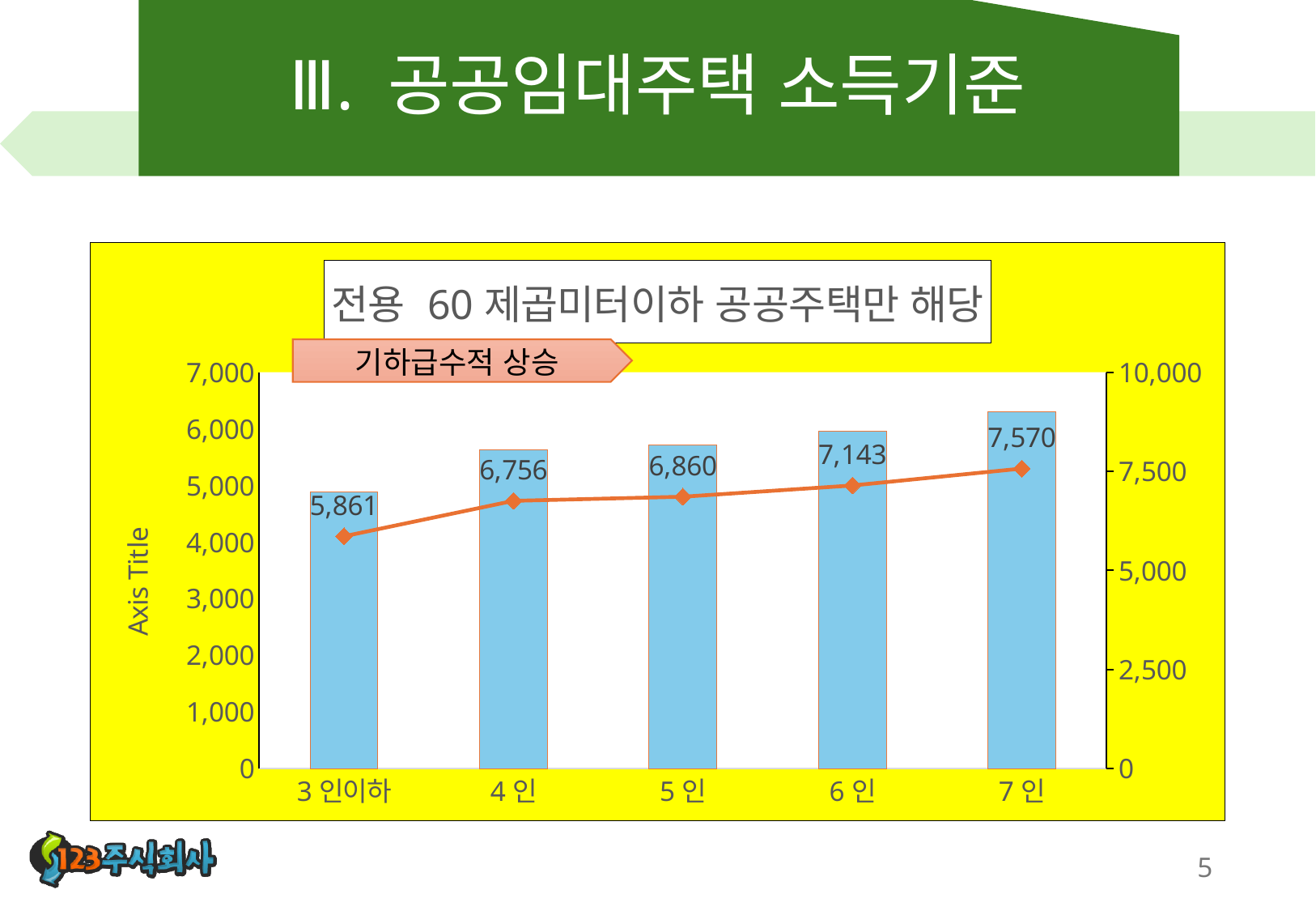
What is the difference between the labelled values for 7 인 and 3 인이하? 1,709 Which category has the lowest labelled value? 3 인이하 Which category has the highest labelled value? 7 인 How many categories are shown on the x axis? 5 What is the labelled value for 7 인? 7,570 What kind of chart is shown? A bar chart combined with a line chart Which has the larger labelled value, 5 인 or 4 인? 5 인 Do the labelled values rise or fall from 3 인이하 to 7 인? rise What is the labelled value for 4 인? 6,756 What is the difference between the labelled values for 6 인 and 5 인? 283 What is the labelled value for 3 인이하? 5,861 On the left axis, is the bar for 7 인 greater or less than 6,000? greater